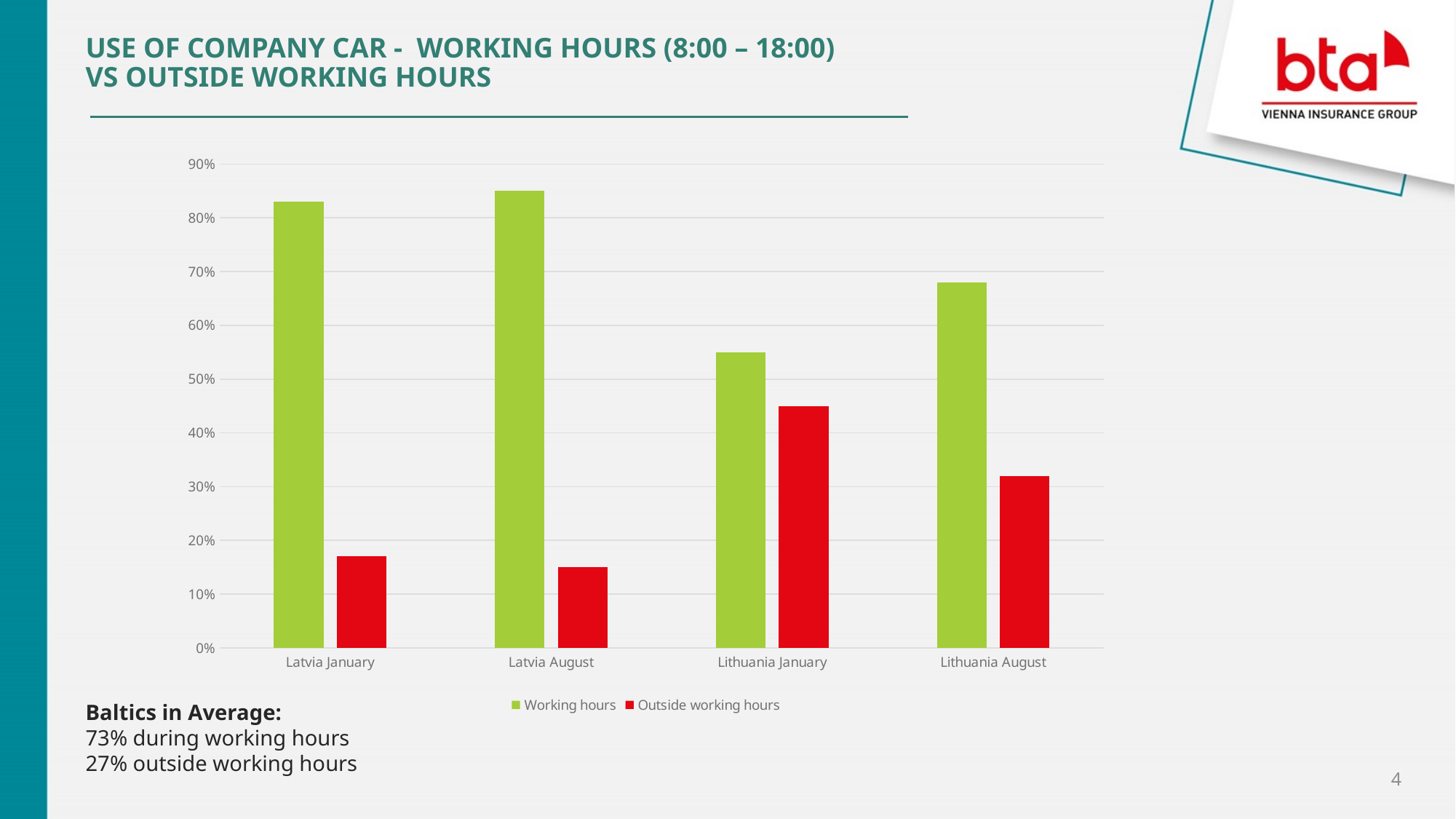
What kind of chart is shown on the slide? bar chart Which category has the lowest Working hours value? Lithuania January Is the Working hours value for Lithuania August greater or less than 70%? less How many categories are shown on the x axis of the chart? 4 Which category has the lowest Outside working hours value? Latvia August Which category has the highest Working hours value? Latvia August Is the Working hours value for Latvia January greater or less than 80%? greater Is the Outside working hours value for Lithuania January greater or less than 40%? greater Which is larger: the Outside working hours value for Lithuania August or for Latvia January? Lithuania August Which colour represents the Outside working hours series in the chart? red Which category has the highest Outside working hours value? Lithuania January How many series does the chart's legend list? 2